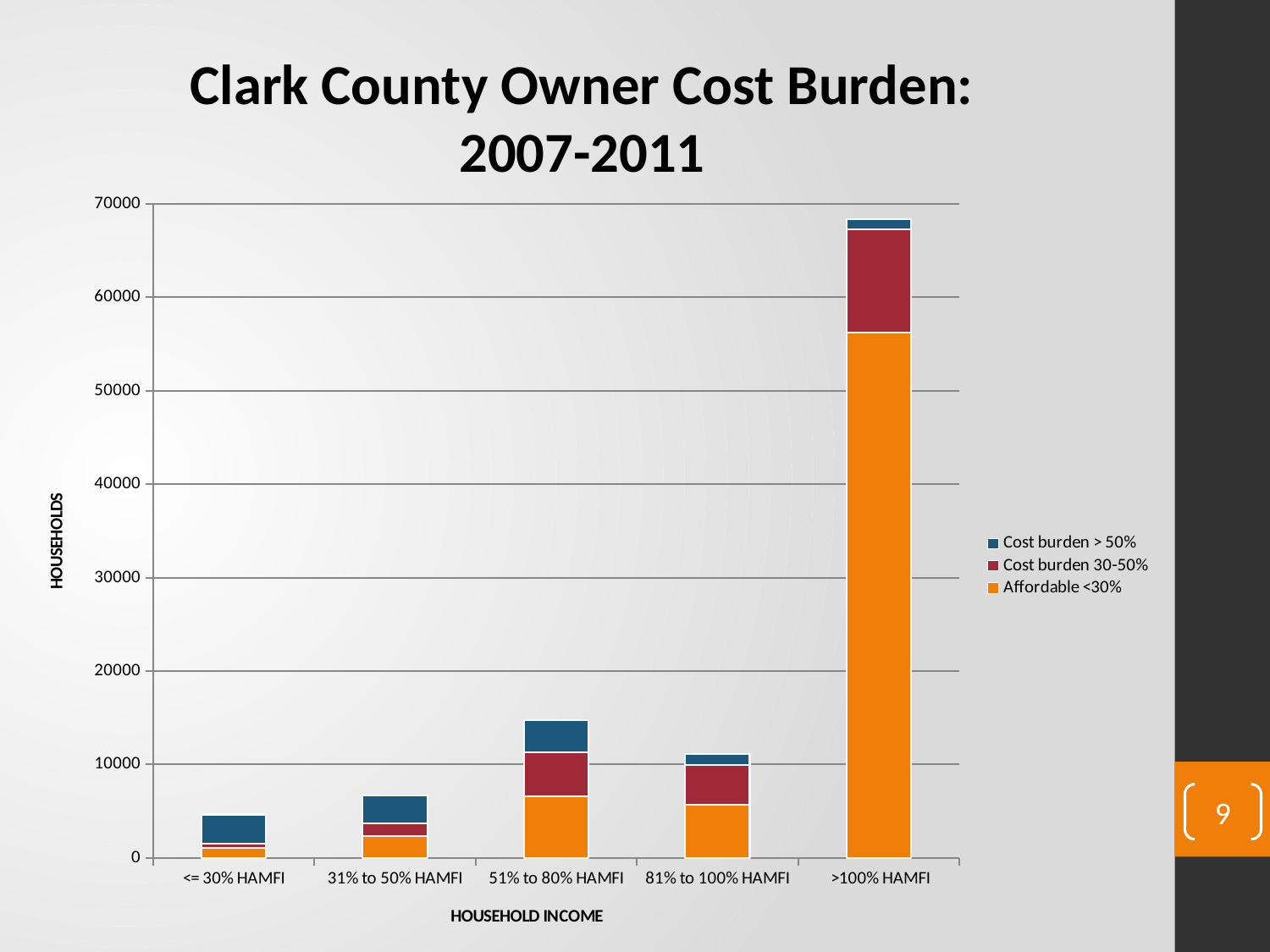
How many series does the legend list? 3 Which has a larger total number of households: 51% to 80% HAMFI or 81% to 100% HAMFI? 51% to 80% HAMFI What is the title of the chart? Clark County Owner Cost Burden: 2007-2011 Which series is shown in orange in the legend? Affordable <30% Is the total number of households for <= 30% HAMFI greater or less than 10000? less Is the Affordable <30% value for >100% HAMFI greater or less than 50000? greater Is the total number of households for 51% to 80% HAMFI greater or less than 10000? greater Which household income category has the highest total number of households? >100% HAMFI How many household income categories are shown on the x axis? 5 What kind of chart is shown on the slide? stacked bar chart Which household income category has the lowest total number of households? <= 30% HAMFI